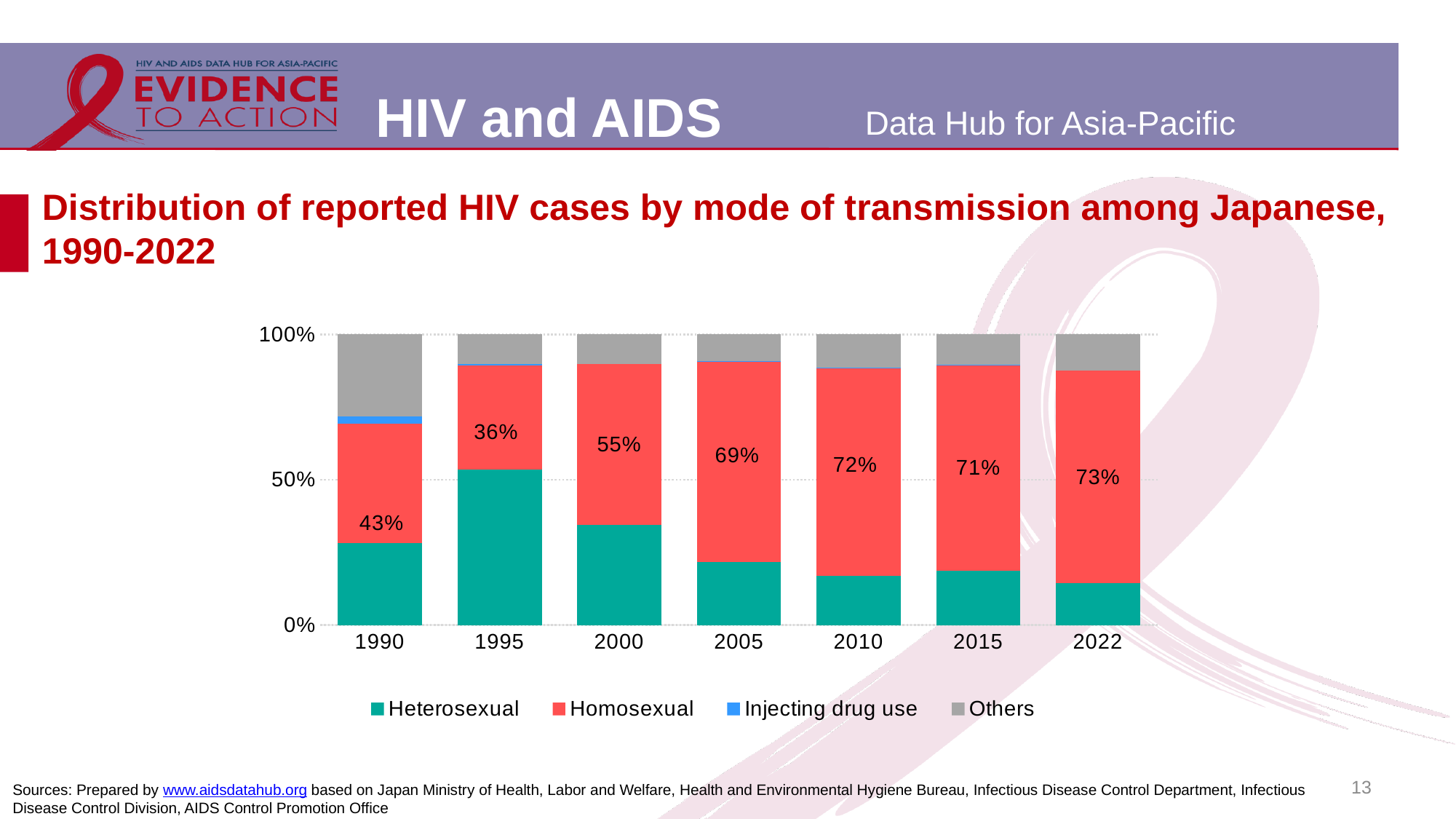
How many modes of transmission does the legend list? 4 In which year is the homosexual transmission share the highest? 2022 Which year has a larger homosexual transmission share, 2000 or 2005? 2005 Is the heterosexual share of cases in 1995 greater or less than 50%? greater Is the heterosexual share of cases in 2022 greater or less than 50%? less What type of chart is used on this slide? Stacked bar chart What is the homosexual transmission share shown for 2022? 73% By how many percentage points did the homosexual transmission share increase from 1990 to 2022? 30 percentage points In which year is the homosexual transmission share the lowest? 1995 What is the data label on the Homosexual segment for 2005? 69% How many years are shown on the x axis of the chart? 7 What percentage of reported HIV cases in 1990 were attributed to homosexual transmission? 43%